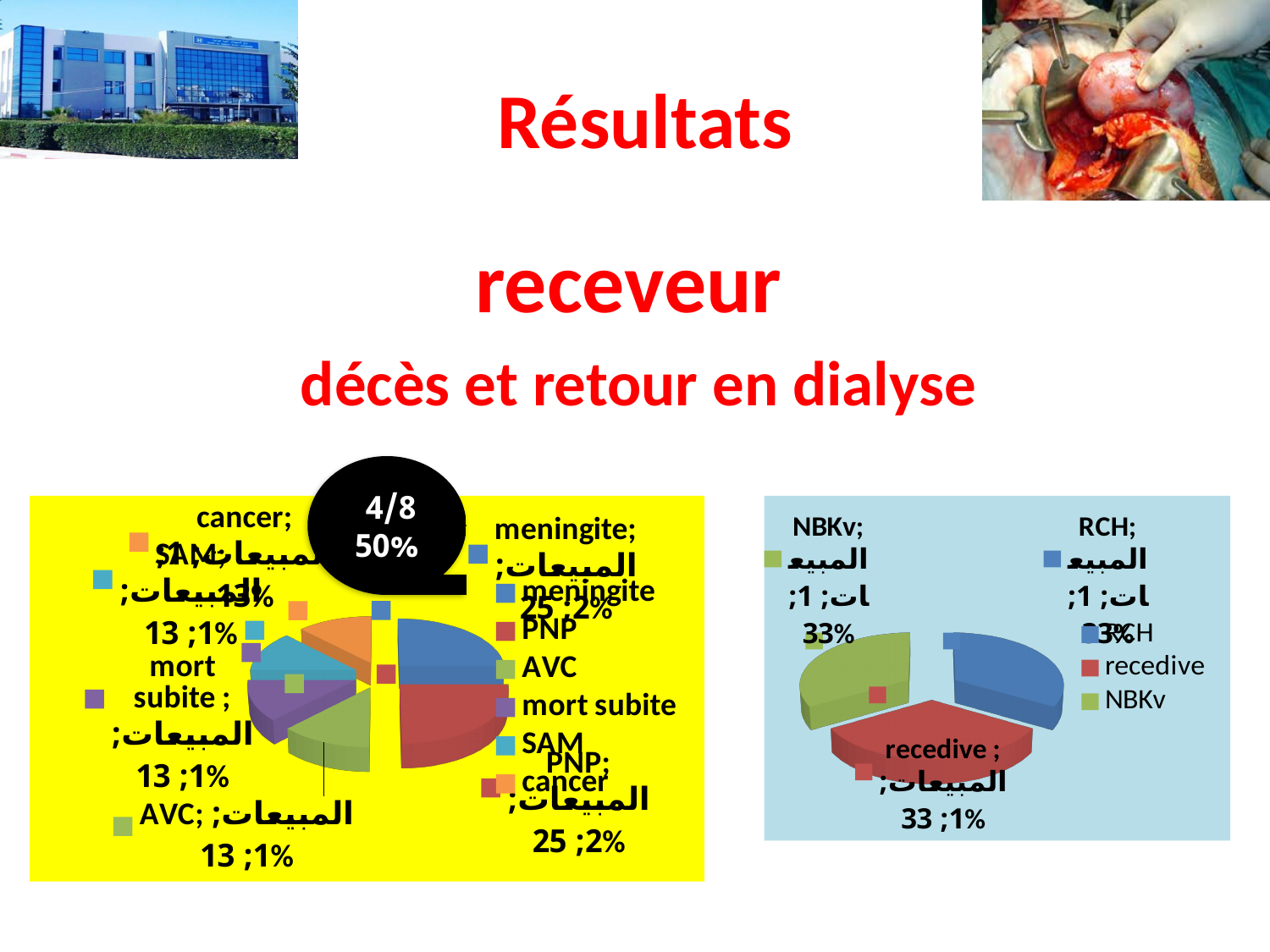
In the left chart, what percentage share is shown for meningite? 25% What are the legend entries of the right chart? RCH, recedive, NBKv In the left chart, what count is shown for PNP? 2 In the left chart, which two categories have the largest share? meningite and PNP In the left chart, which is larger, the share for meningite or the share for SAM? meningite In the left chart, what is the difference in percentage points between the share for meningite and the share for mort subite? 12 What kind of chart is the left chart on the slide? pie chart In the right chart, what percentage share is shown for recedive? 33% How many categories does the legend of the right chart list? 3 What kind of chart is the right chart on the slide? pie chart How many categories does the legend of the left chart list? 6 In the left chart, what percentage share is shown for AVC? 13%